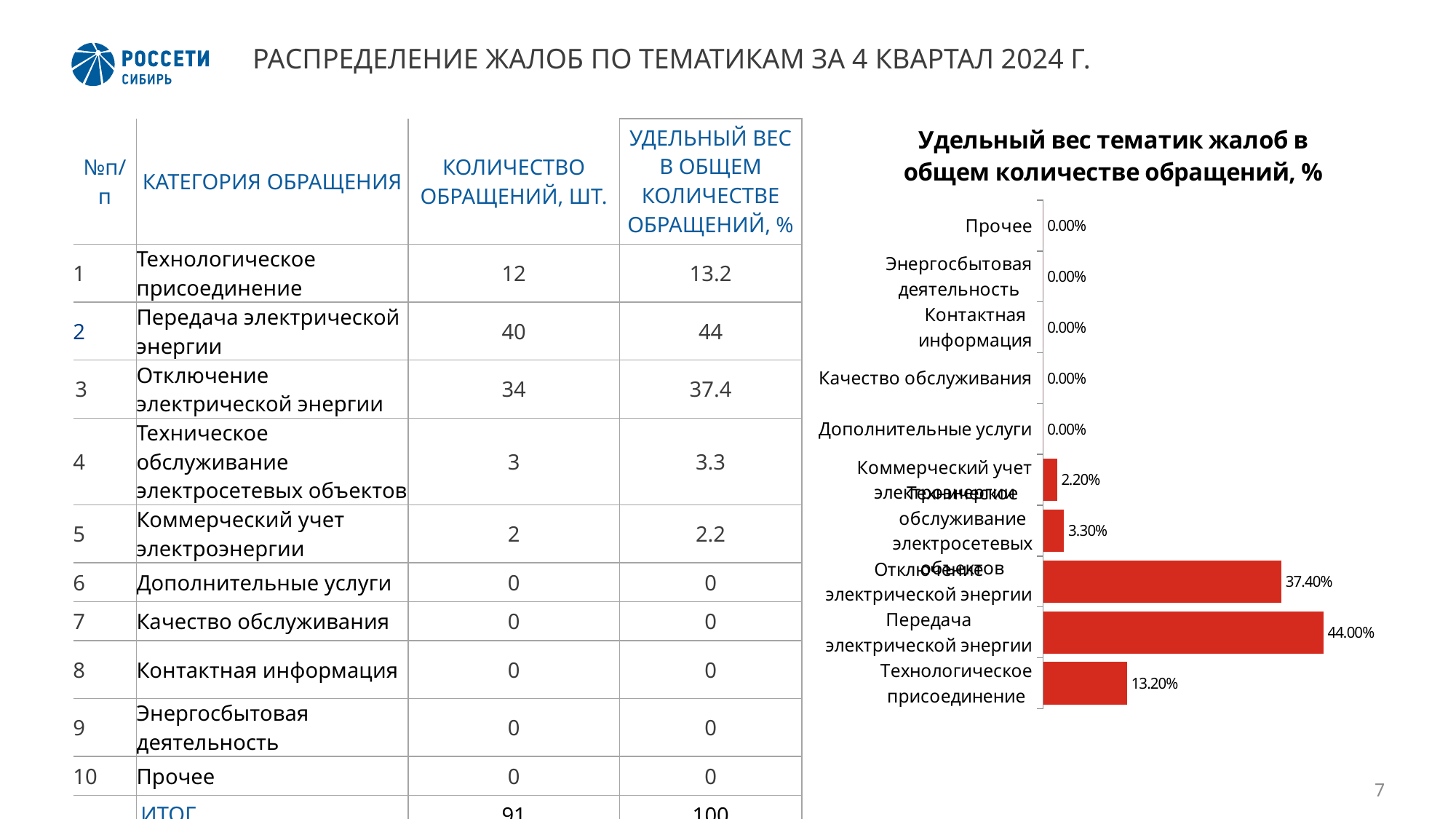
How many categories are shown in the chart? 10 What is the value for Передача электрической энергии in the chart? 44.00% How many categories in the chart have a value of 0.00%? 5 Which is larger in the chart: Технологическое присоединение or Коммерческий учет электроэнергии? Технологическое присоединение What is the difference between the values for Передача электрической энергии and Отключение электрической энергии? 6.60% What is the value for Коммерческий учет электроэнергии in the chart? 2.20% What type of chart is shown on the slide? bar chart What colour are the bars in the chart? red What is the value for Технологическое присоединение in the chart? 13.20% What is the value for Отключение электрической энергии in the chart? 37.40% What is the title of the chart? Удельный вес тематик жалоб в общем количестве обращений, % Which category has the highest value in the chart? Передача электрической энергии